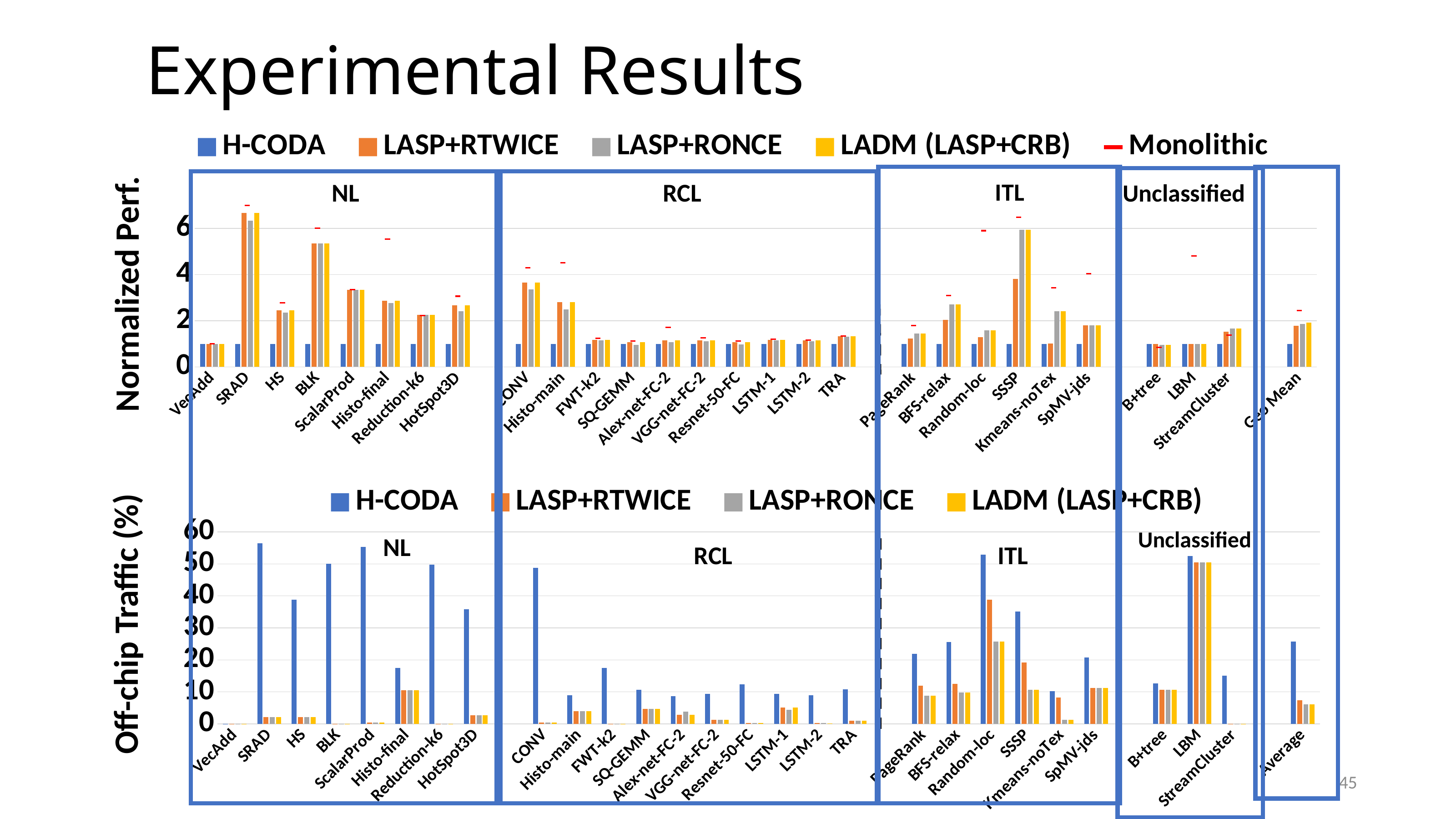
In the bottom chart (Off-chip Traffic), which has the larger H-CODA value, SRAD or Histo-final? SRAD How many categories are in the Unclassified group of the bottom chart (Off-chip Traffic)? 3 What kind of chart is the top chart (Normalized Perf.)? combination bar and line chart In the bottom chart (Off-chip Traffic), is the H-CODA value for Histo-final greater or less than 20? less In the top chart (Normalized Perf.), is the LADM (LASP+CRB) value for SRAD greater or less than 6? greater How many series does the legend of the top chart (Normalized Perf.) list? 5 What is the y-axis title of the bottom chart? Off-chip Traffic (%) In the bottom chart (Off-chip Traffic), is the H-CODA value for Average greater or less than 20? greater How many series does the legend of the bottom chart (Off-chip Traffic) list? 4 In the top chart (Normalized Perf.), which has the larger LADM (LASP+CRB) value, SRAD or HS? SRAD